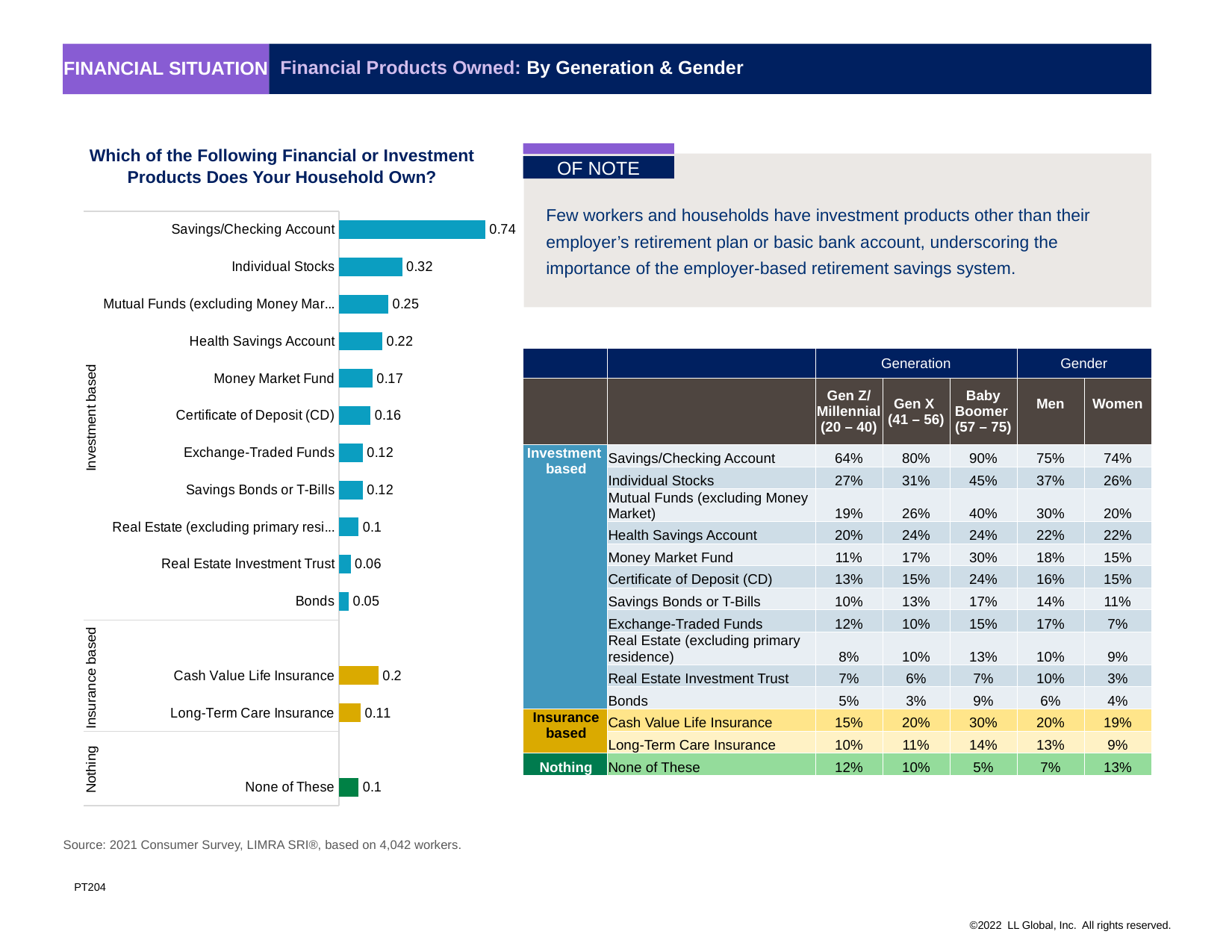
Which category has the lowest value in the chart? Bonds What kind of chart is shown on the slide? Bar chart What is the value for Savings/Checking Account? 0.74 What is the title of the chart? Which of the Following Financial or Investment Products Does Your Household Own? What is the value for Health Savings Account? 0.22 What is the difference between the values for Savings/Checking Account and Individual Stocks? 0.42 How many categories are plotted in the chart? 14 What is the value for Cash Value Life Insurance? 0.2 What is the value for None of These? 0.1 Which is larger, the value for Cash Value Life Insurance or the value for Long-Term Care Insurance? Cash Value Life Insurance Which category has the highest value in the chart? Savings/Checking Account What is the difference between the values for Individual Stocks and Money Market Fund? 0.15